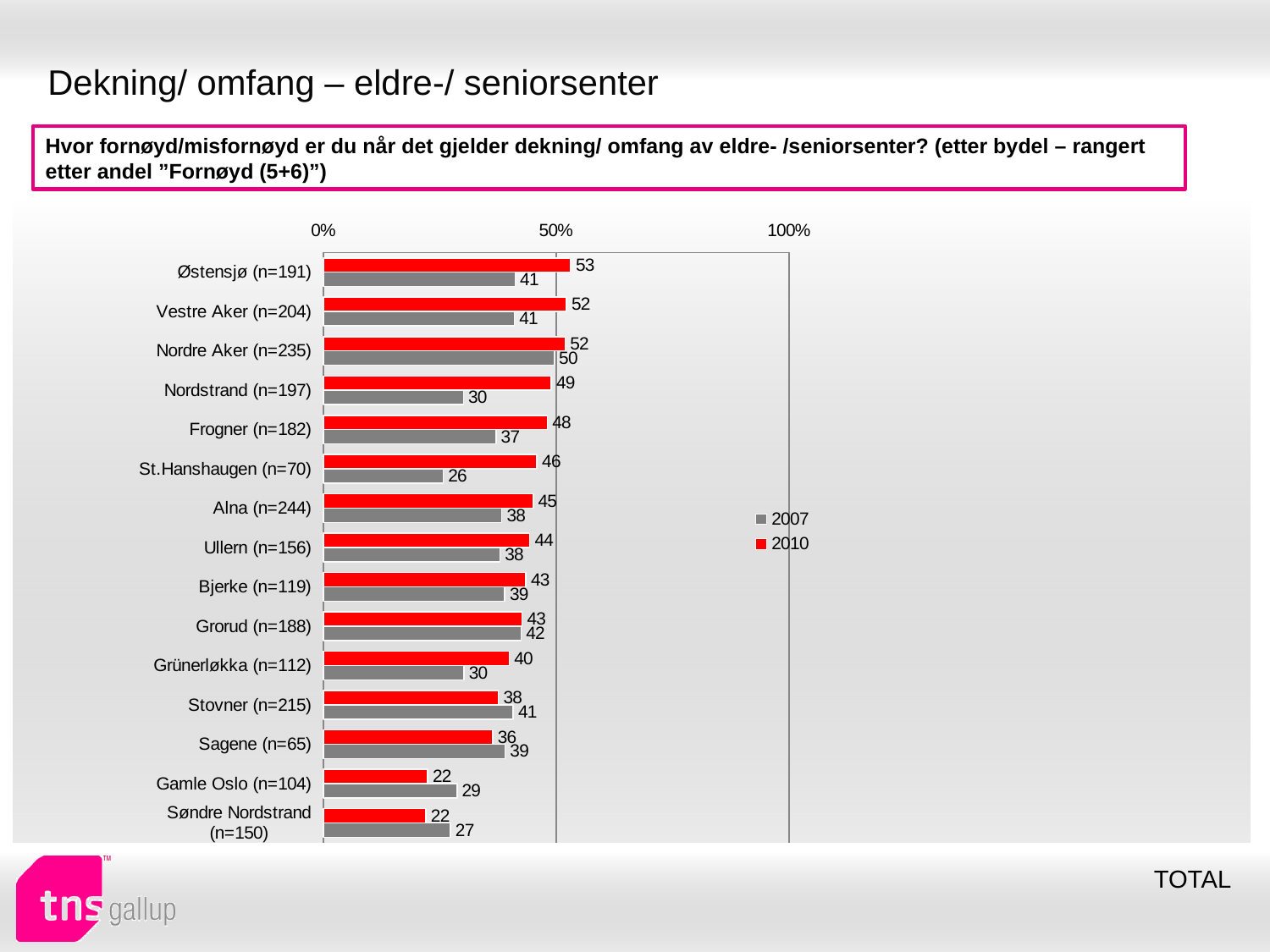
How many bydeler are shown in the chart? 15 What is the 2010 value for St.Hanshaugen (n=70)? 46 What is the 2010 value for Østensjø (n=191)? 53 What is the difference between the 2010 and 2007 values for Nordstrand (n=197)? 19 What kind of chart is shown on the slide? Bar chart For Stovner (n=215), which is larger: the 2007 value or the 2010 value? 2007 What is the 2007 value for Nordstrand (n=197)? 30 How many series does the legend list? 2 Which bydel has the highest 2007 value? Nordre Aker (n=235) Which bydel has the lowest 2007 value? St.Hanshaugen (n=70) Which bydel has the highest 2010 value? Østensjø (n=191) Is the 2010 value for Gamle Oslo (n=104) greater or less than 50%? less